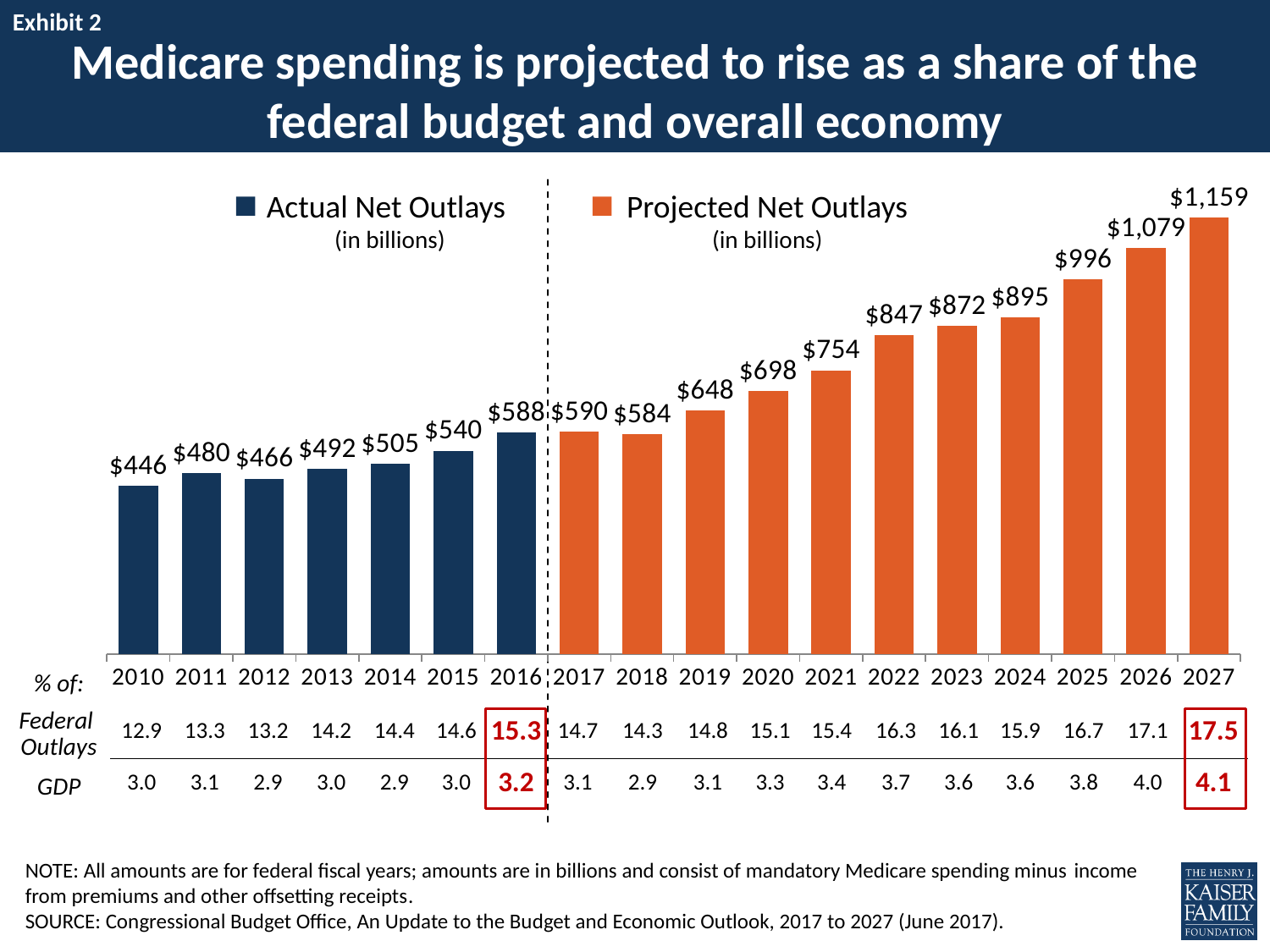
What is the Projected Net Outlays value for 2027? $1,159 Which year has the lowest net outlays value? 2010 How many series does the legend list? 2 Which year has the highest net outlays value? 2027 How many years are shown on the x axis? 18 What kind of chart is shown on the slide? Bar chart What is the Actual Net Outlays value for 2010? $446 What colour are the Projected Net Outlays bars? Orange What is the Projected Net Outlays value for 2021? $754 Do the Projected Net Outlays values generally rise or fall from 2018 to 2027? Rise What is the difference between the net outlays for 2027 and 2016? $571 Which is larger, the net outlays for 2017 or for 2018? 2017